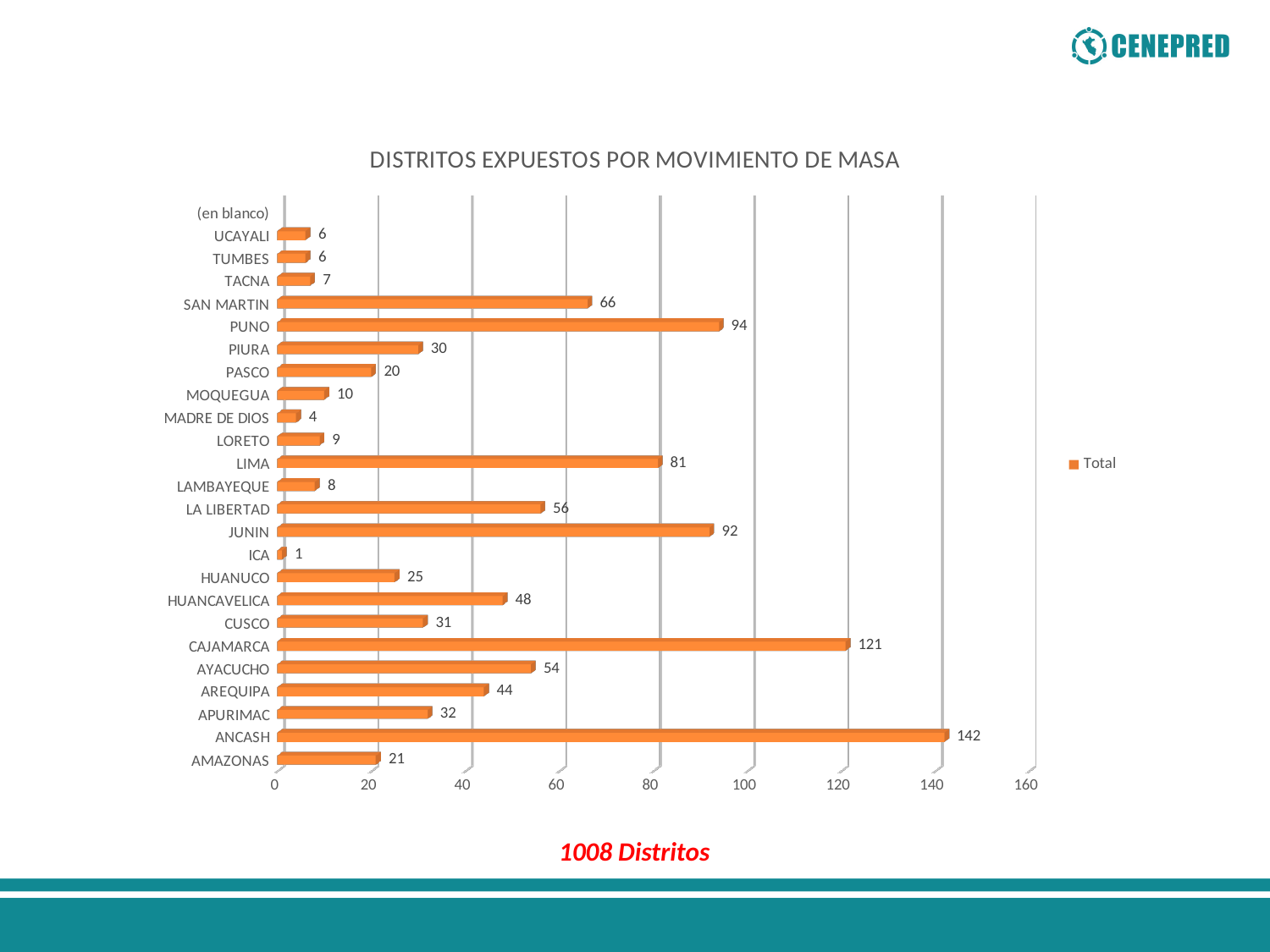
What is the value for MADRE DE DIOS? 4 Is the value for SAN MARTIN greater or less than 60? greater What is the title of the chart? DISTRITOS EXPUESTOS POR MOVIMIENTO DE MASA What is the total of all the values shown in the chart, as stated on the slide? 1008 Distritos What is the difference between the values for ANCASH and CAJAMARCA? 21 What is the value for CAJAMARCA? 121 Which is larger, the value for LIMA or the value for PUNO? PUNO What is the value for LA LIBERTAD? 56 Which category with a plotted bar has the lowest value? ICA How many series does the legend list? 1 Which category has the highest value? ANCASH What type of chart is shown on the slide? Bar chart